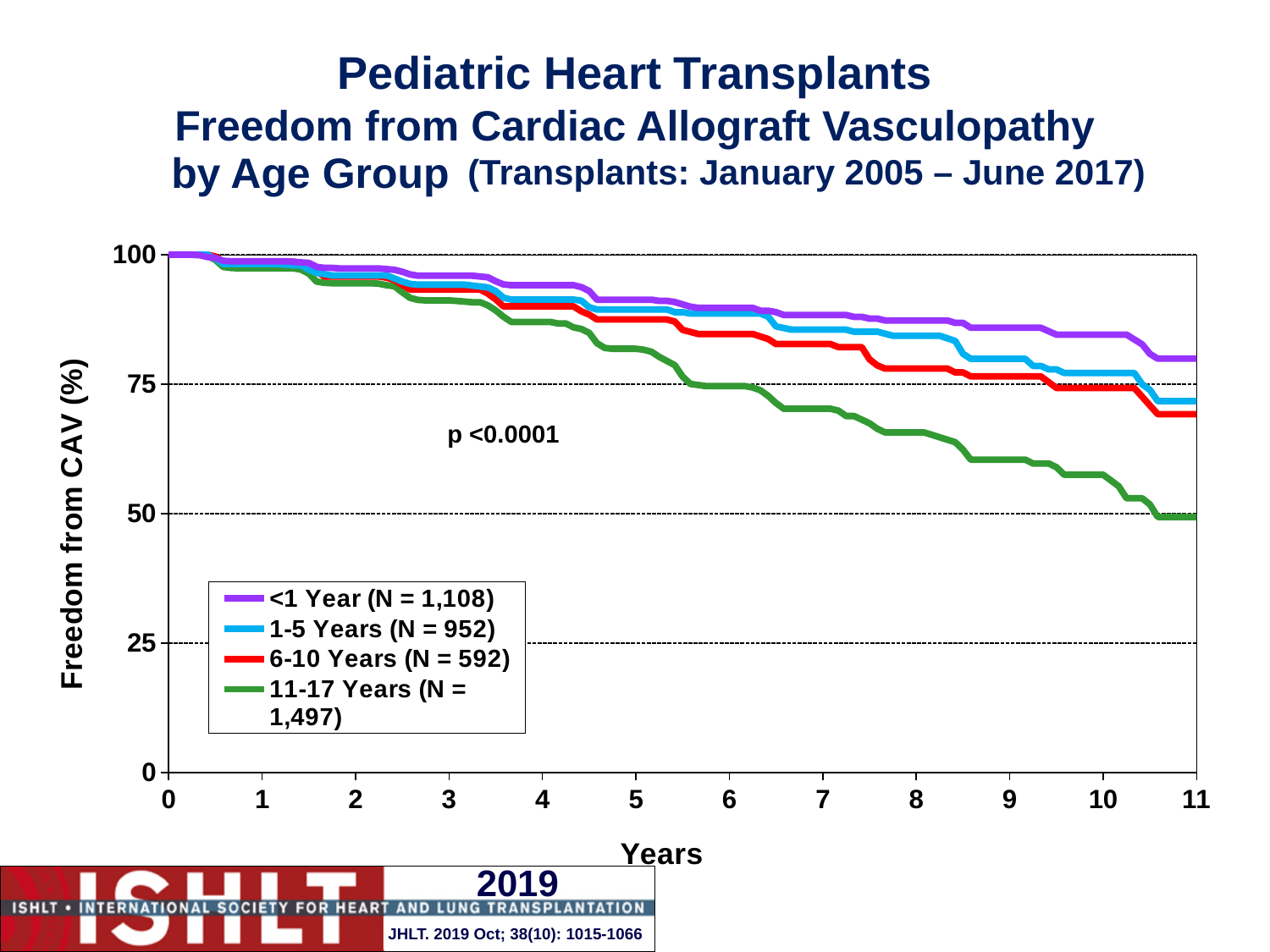
What is the freedom from CAV value for the <1 Year group at 0 years? 100 What p-value is shown on the chart? p <0.0001 According to the legend, what is N for the 11-17 Years group? 1,497 Which age group has the lowest freedom from CAV at 11 years? 11-17 Years What kind of chart is shown on the slide? line chart Do the freedom from CAV values rise or fall as years increase? fall At 11 years, which is larger: the freedom from CAV for the <1 Year group or the 11-17 Years group? <1 Year How many series does the legend list? 4 Is the freedom from CAV for the 11-17 Years group at 8 years greater or less than 75? less Is the freedom from CAV for the <1 Year group at 11 years greater or less than 75? greater Is the freedom from CAV for the 11-17 Years group at 10 years greater or less than 50? greater Which age group has the highest freedom from CAV at 11 years? <1 Year